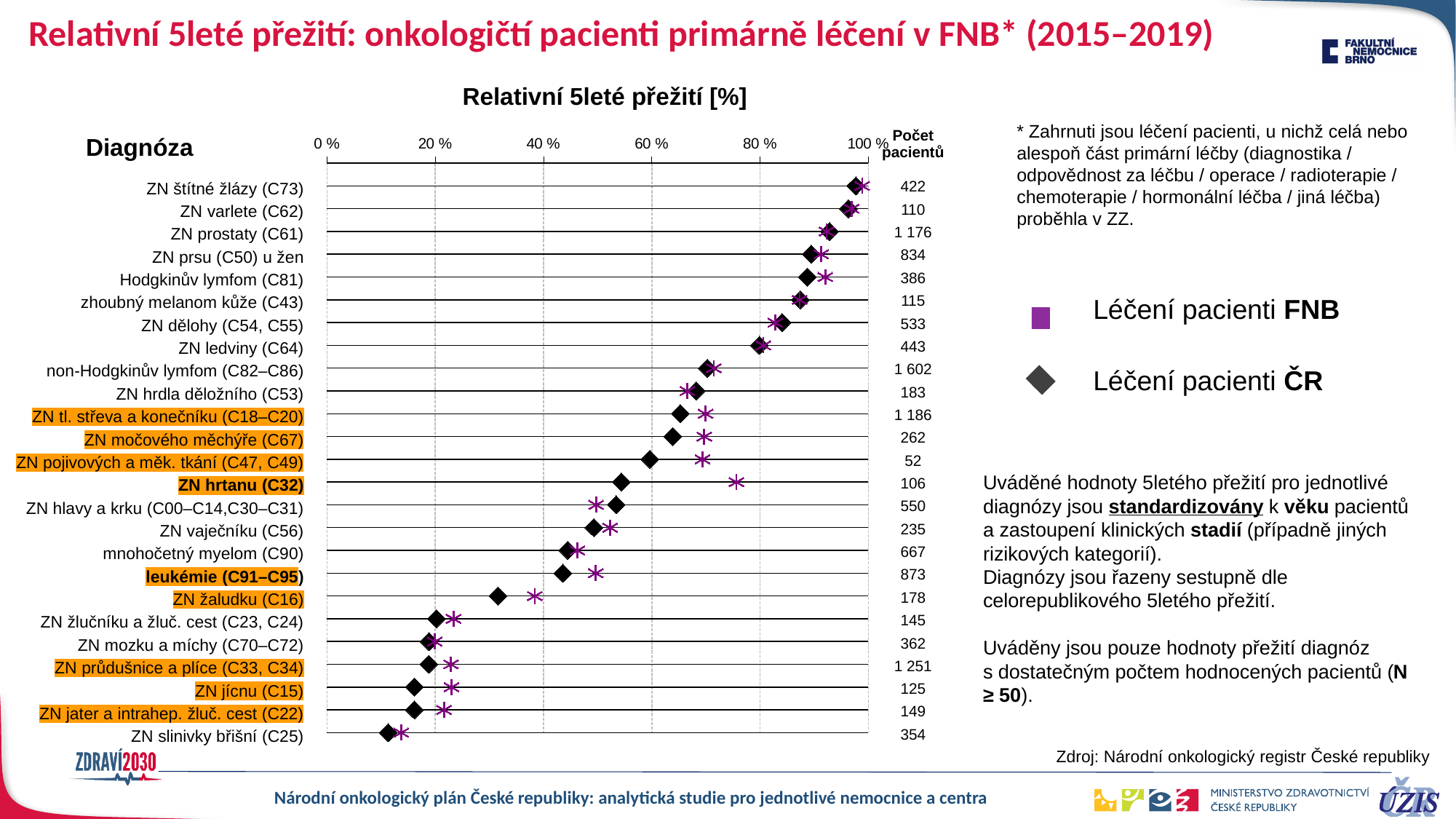
For ZN hrtanu (C32), which is larger: the FNB value or the ČR value? FNB What is the number of patients for non-Hodgkinův lymfom (C82–C86)? 1 602 What is the difference in patient count between non-Hodgkinův lymfom (C82–C86) and ZN průdušnice a plíce (C33, C34)? 351 Which diagnosis has the highest number of patients? non-Hodgkinův lymfom (C82–C86) How many series does the legend list? 2 What is the number of patients (Počet pacientů) for ZN prostaty (C61)? 1 176 Which colour marks the 'Léčení pacienti FNB' series in the legend? Purple Is the ČR 5-year survival value for ZN slinivky břišní (C25) greater or less than 20 %? less Which diagnosis has the lowest number of patients? ZN pojivových a měk. tkání (C47, C49) How many diagnoses are listed on the chart? 25 What kind of chart is used to show the relative 5-year survival values? Scatter (dot) chart Is the FNB 5-year survival value for ZN hrtanu (C32) greater or less than 60 %? greater